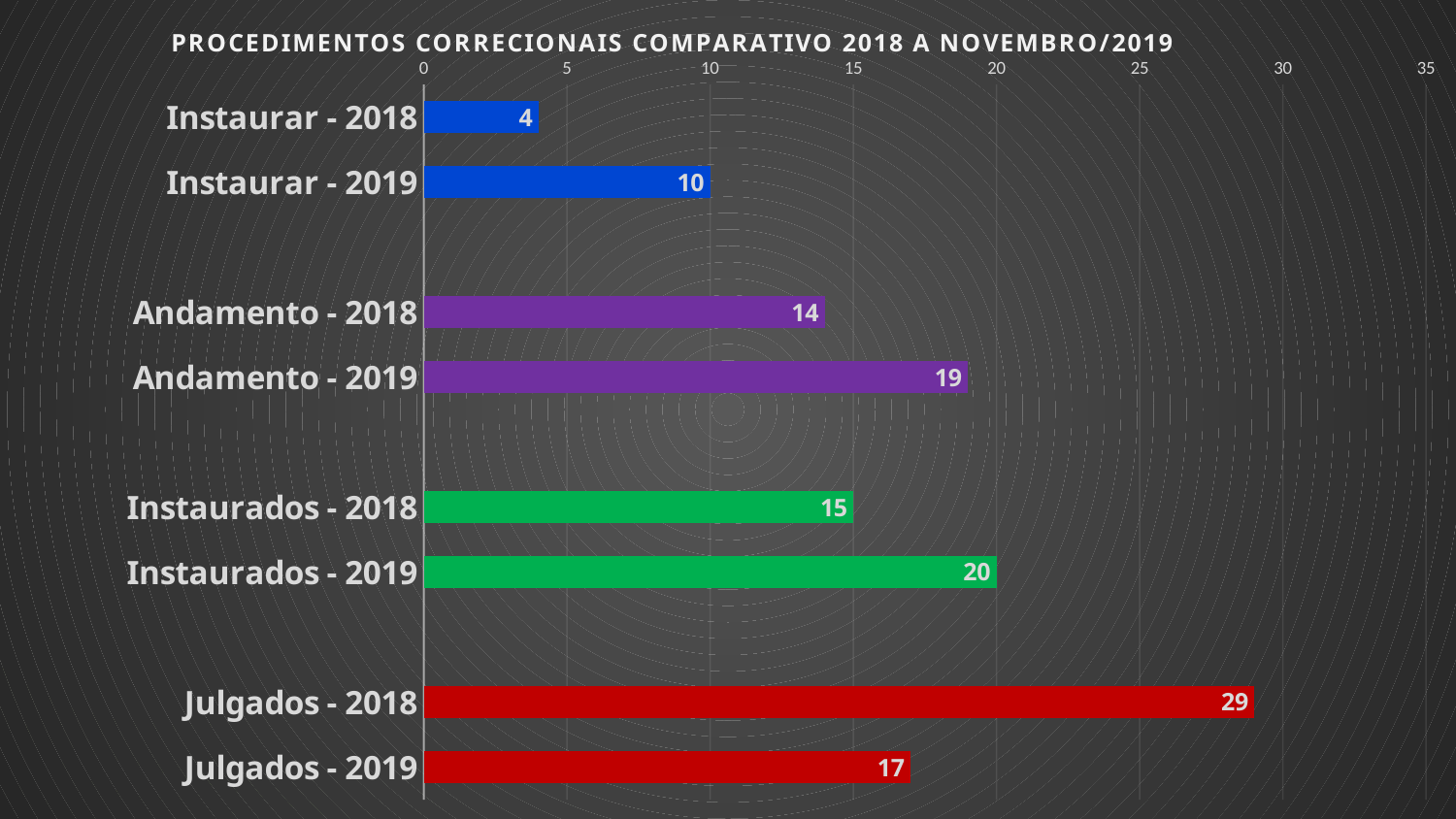
What is the value for Instaurar - 2018? 4 Which is larger, Andamento - 2018 or Instaurados - 2018? Instaurados - 2018 What is the difference between Julgados - 2018 and Julgados - 2019? 12 What is the difference between Instaurados - 2019 and Instaurados - 2018? 5 What is the value for Julgados - 2019? 17 Which category has the lowest value? Instaurar - 2018 How many bars are shown in the chart? 8 What is the value for Andamento - 2019? 19 What is the title of the chart? PROCEDIMENTOS CORRECIONAIS COMPARATIVO 2018 A NOVEMBRO/2019 What kind of chart is this? bar chart Is the value for Julgados - 2018 greater or less than 25? greater Which category has the highest value? Julgados - 2018